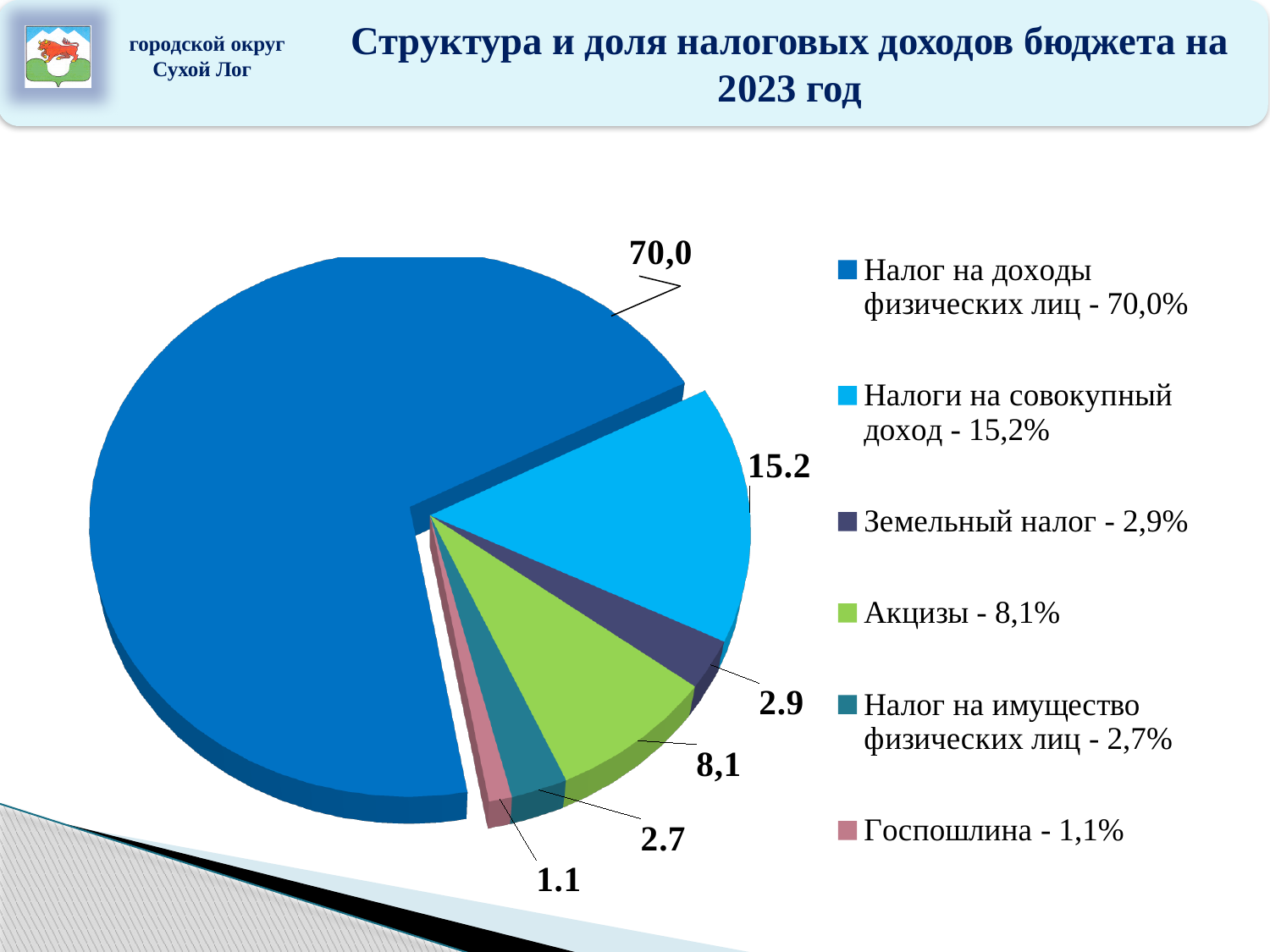
What share of tax revenues is Налог на доходы физических лиц? 70,0% Which is larger: the share of Земельный налог or the share of Налог на имущество физических лиц? Земельный налог What is the title of the slide containing the chart? Структура и доля налоговых доходов бюджета на 2023 год What share is shown for Акцизы? 8,1% Which category has the largest share of the pie? Налог на доходы физических лиц How many slices does the pie chart have? 6 What kind of chart is shown on the slide? Pie chart What share is shown for Госпошлина? 1,1% What is the difference in percentage points between Налог на доходы физических лиц and Налоги на совокупный доход? 54,8 Which category has the smallest share of the pie? Госпошлина What share is shown for Налоги на совокупный доход? 15,2% How many entries does the legend list? 6